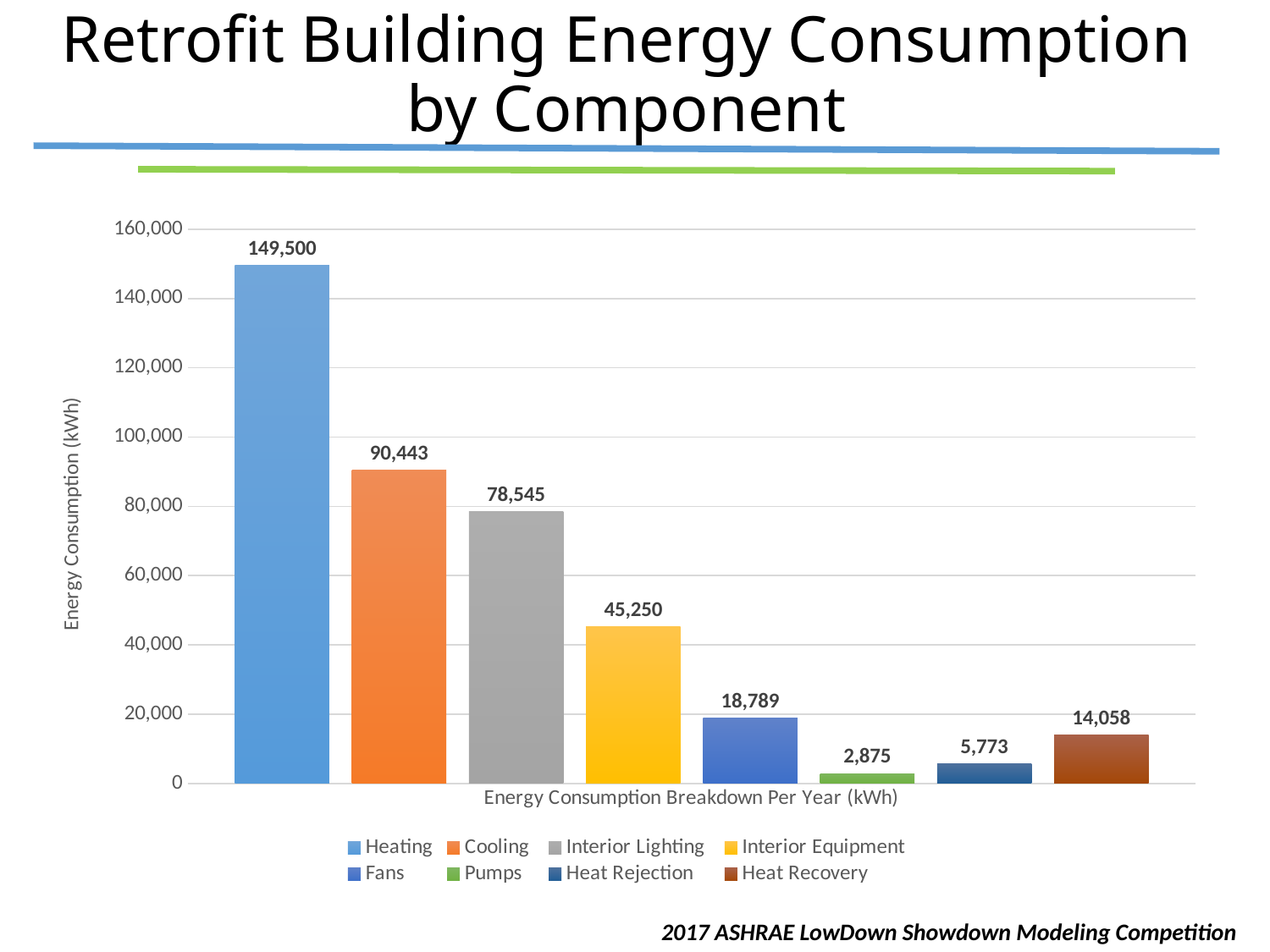
What is the energy consumption value for Heating? 149,500 What is the difference in energy consumption between Cooling and Interior Lighting? 11,898 What is the label of the vertical axis? Energy Consumption (kWh) What kind of chart is shown on the slide? Bar chart How many components are plotted in the chart? 8 How many series does the legend list? 8 What is the energy consumption value for Interior Lighting? 78,545 Which component has the highest energy consumption? Heating Is the value for Interior Equipment greater or less than 40,000? greater Which has a larger energy consumption value, Fans or Heat Recovery? Fans Which component has the lowest energy consumption? Pumps What is the energy consumption value for Pumps? 2,875